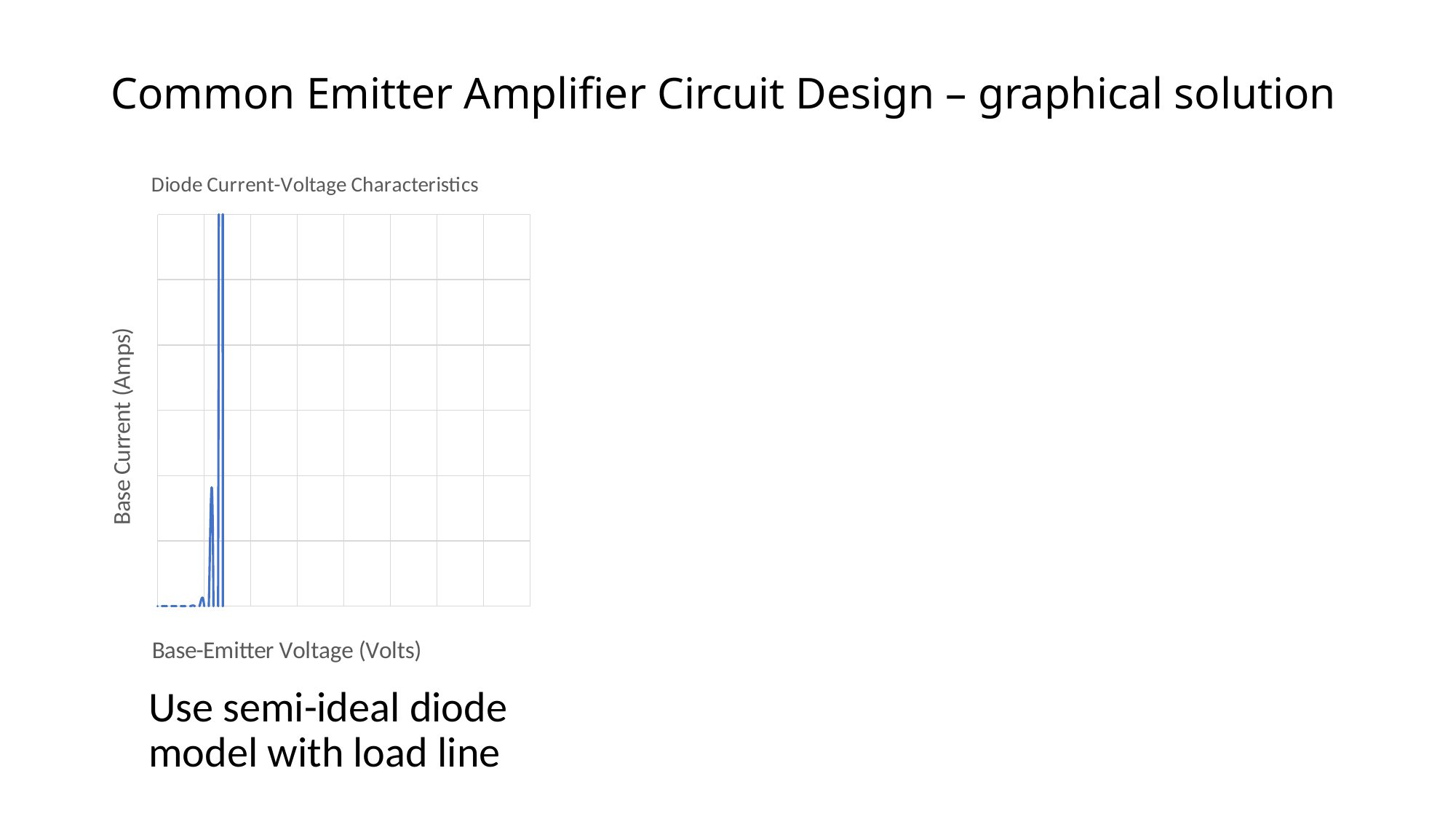
Moving from left to right along the x axis, does the plotted base current rise or fall? rise What kind of chart is shown on the slide? line chart What is the label of the vertical axis of the chart? Base Current (Amps) What is the title of the chart on the slide? Diode Current-Voltage Characteristics